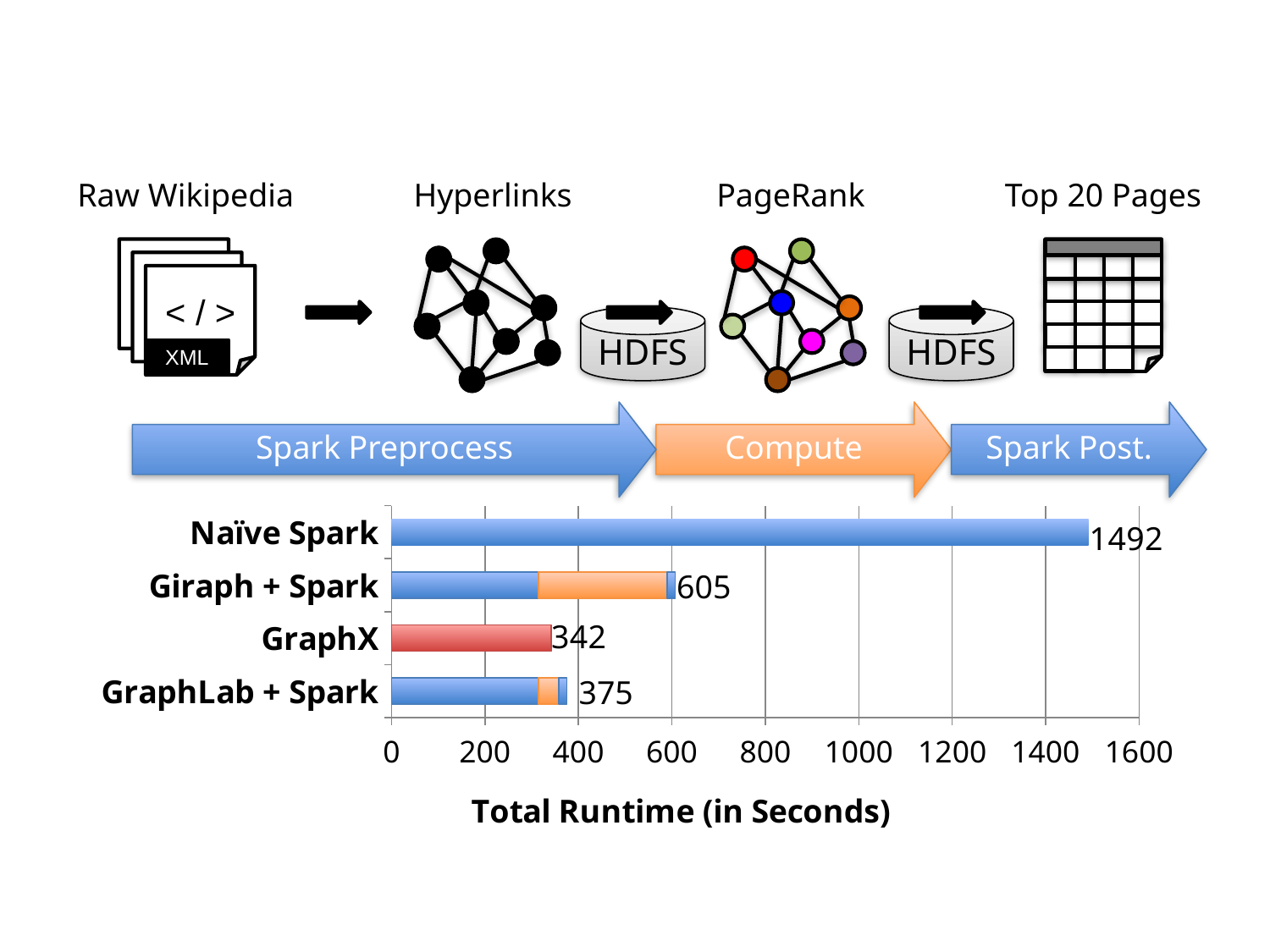
What is the difference in total runtime between GraphLab + Spark and GraphX? 33 What is the total runtime for GraphX? 342 What is the total runtime for GraphLab + Spark? 375 What is the total runtime for Giraph + Spark? 605 Which system has the lowest total runtime? GraphX Which system has the highest total runtime? Naïve Spark Which has a larger total runtime, Giraph + Spark or GraphLab + Spark? Giraph + Spark What is the difference in total runtime between Naïve Spark and Giraph + Spark? 887 What is the title of the horizontal axis? Total Runtime (in Seconds) How many systems are compared in the chart? 4 What is the total runtime for Naïve Spark? 1492 Is the total runtime for Naïve Spark greater or less than 1400? greater